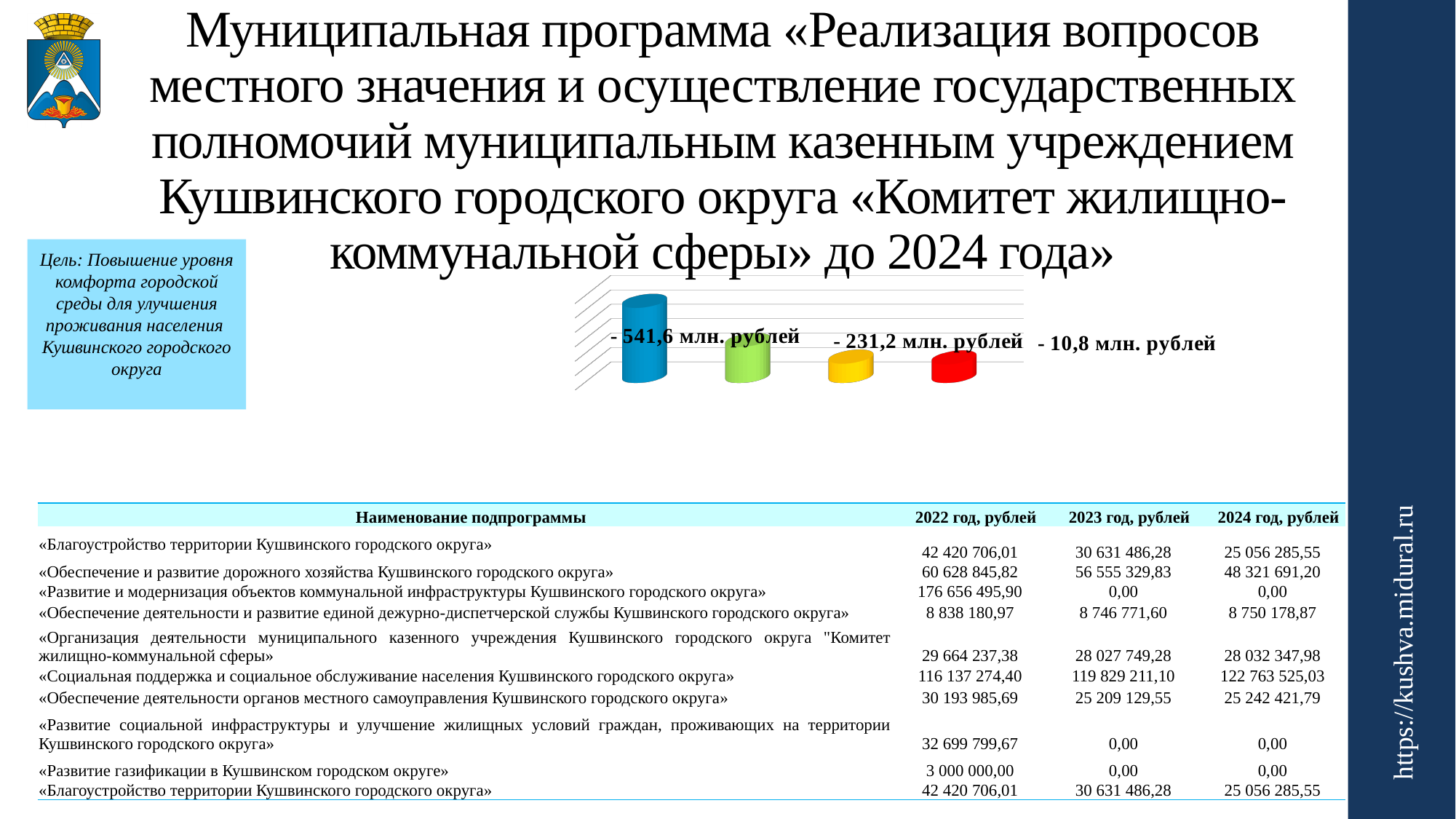
What kind of chart is shown on the slide? bar chart What is the largest value labelled on the chart? 541,6 млн. рублей What is the smallest value labelled on the chart? 10,8 млн. рублей Is the red bar taller or shorter than the blue bar? shorter How many bars does the chart contain? 4 Do the bar heights rise or fall from left to right across the chart? fall Which bar in the chart is the tallest? the blue (leftmost) bar What colours are the four bars in the chart, from left to right? blue, green, yellow, red Is the blue bar taller or shorter than the green bar? taller How many value labels (in млн. рублей) are printed next to the chart? 3